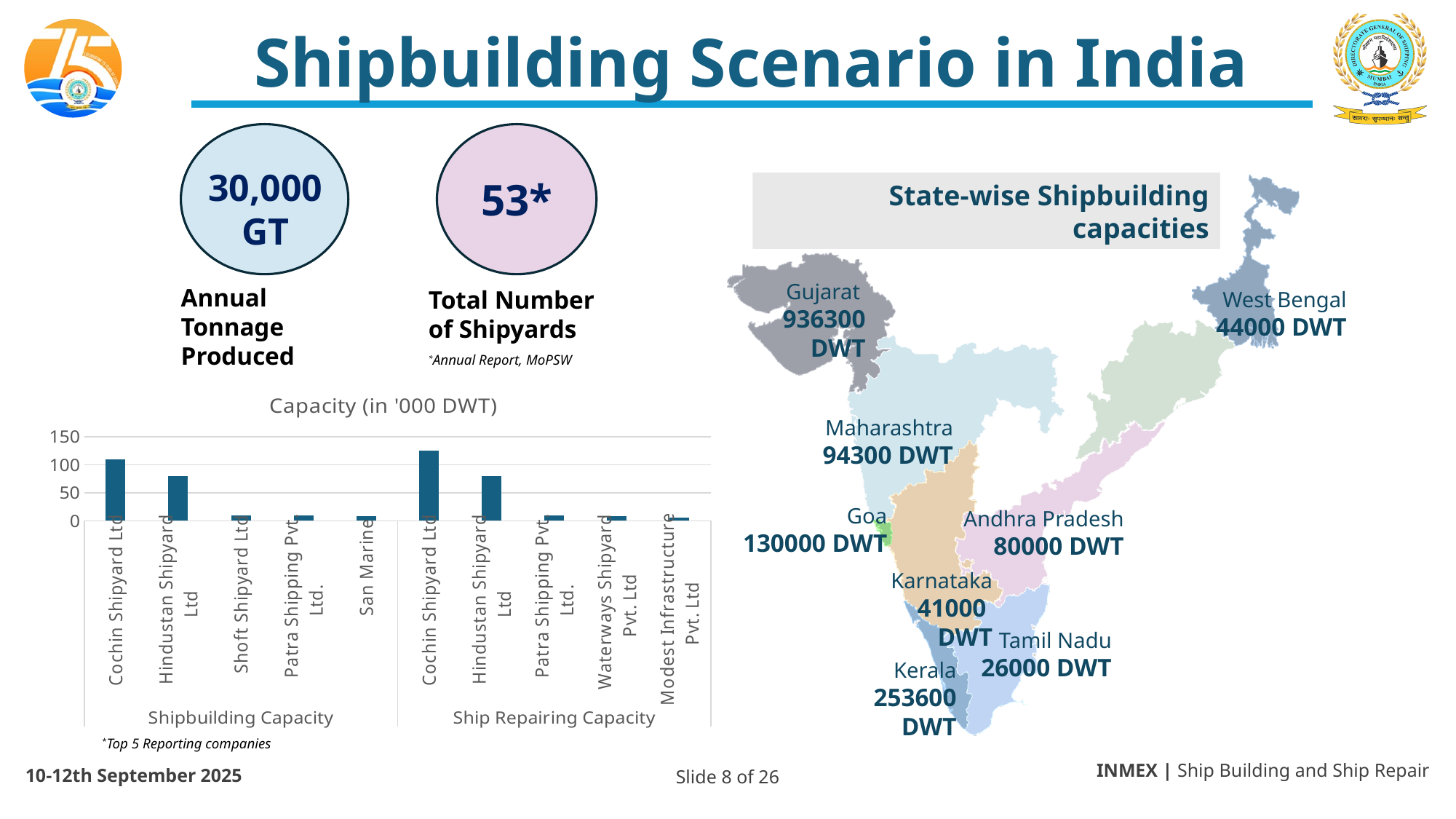
What is the title of the bar chart? Capacity (in '000 DWT) What are the two groups into which the bars in the bar chart are divided? Shipbuilding Capacity and Ship Repairing Capacity In the bar chart, is the Shipbuilding Capacity value for Cochin Shipyard Ltd greater or less than 100? greater In the bar chart, is the Shipbuilding Capacity value for Hindustan Shipyard Ltd greater or less than 100? less In the bar chart, is the Ship Repairing Capacity value for Cochin Shipyard Ltd greater or less than 100? greater In the Shipbuilding Capacity group of the bar chart, which is larger: Hindustan Shipyard Ltd or Shoft Shipyard Ltd? Hindustan Shipyard Ltd What kind of chart is shown on the left of the slide? bar chart In the Shipbuilding Capacity group of the bar chart, which company has the highest value? Cochin Shipyard Ltd How many bars are plotted in the bar chart in total? 10 In the Ship Repairing Capacity group of the bar chart, which company has the highest value? Cochin Shipyard Ltd How many companies are shown in the Ship Repairing Capacity group of the bar chart? 5